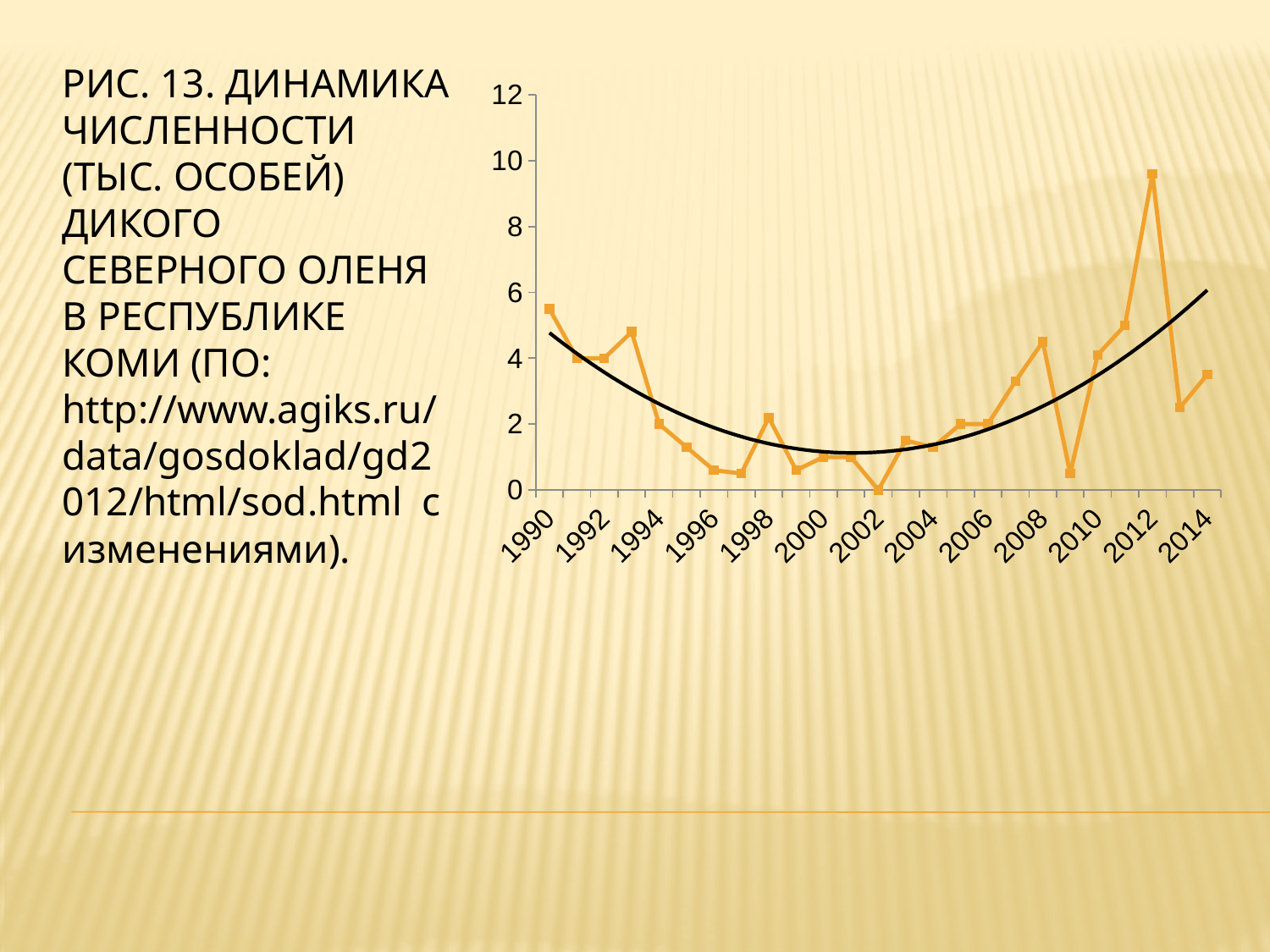
How many year labels are shown on the x axis? 13 Do the values rise or fall from 1990 to 1997? fall Which year has the lowest value on the chart? 2002 Is the value for 2012 greater or less than 8? greater Which year has the highest value on the chart? 2012 Is the value for 2008 greater or less than 4? greater What is the highest value shown on the y axis? 12 Is the value for 1990 greater or less than 4? greater Which year has the larger value, 1990 or 1994? 1990 What kind of chart is shown on the slide? line chart Which year has the larger value, 2012 or 2014? 2012